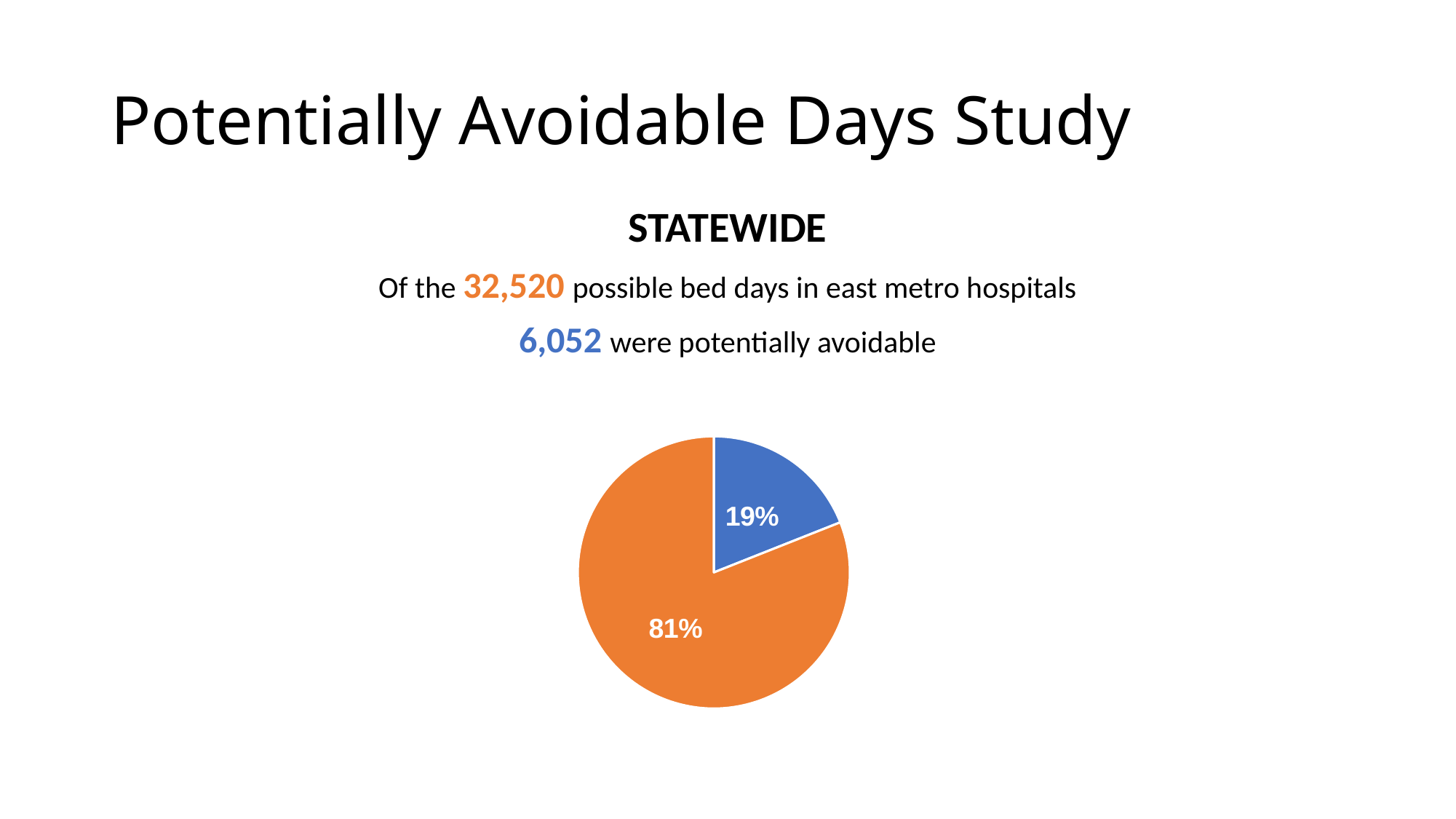
What colour is the slice labelled 81%? orange What percentage is shown on the blue slice of the pie chart? 19% Which slice of the pie chart is the largest? the orange slice (81%) Is the blue slice or the orange slice larger? the orange slice What percentage is shown on the orange slice of the pie chart? 81% What kind of chart is shown on the slide? pie chart Does the pie chart include a legend? No What share of the pie does the blue slice represent? 19% Which slice of the pie chart is the smallest? the blue slice (19%) What is the difference in percentage points between the orange slice and the blue slice? 62 How many slices does the pie chart have? 2